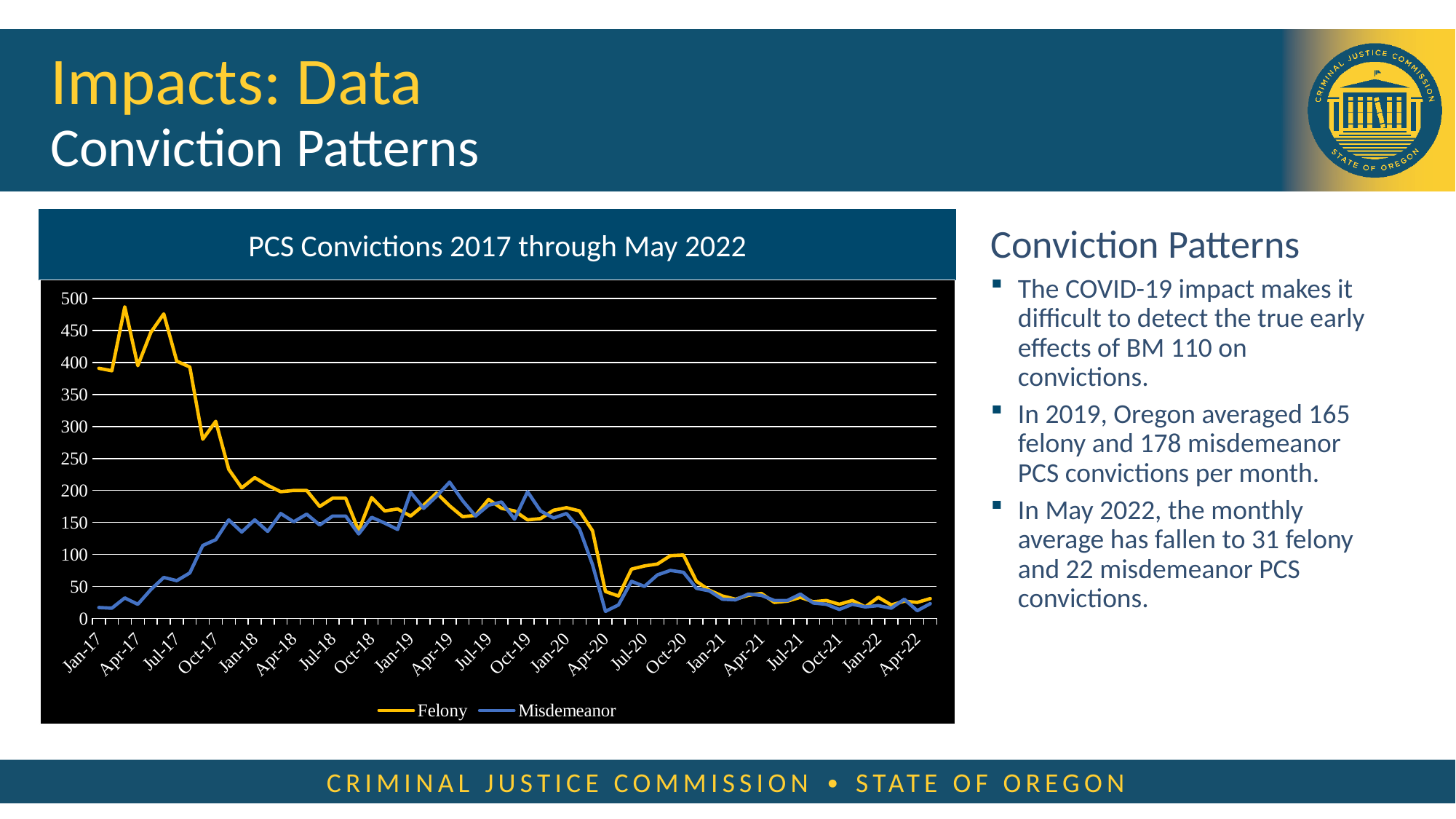
In Oct-19, which series has the larger value, Felony or Misdemeanor? Misdemeanor Which series reaches the highest value anywhere on the chart? Felony Overall, does the Felony line rise or fall from Jan-17 to Apr-22? fall In Jan-17, which series has the larger value, Felony or Misdemeanor? Felony Is the Felony value for Apr-20 greater or less than 100? less What kind of chart is shown on the slide? line chart Is the Misdemeanor value for Apr-19 greater or less than 150? greater What is the title of the chart? PCS Convictions 2017 through May 2022 How many series does the legend of the chart list? 2 Is the Felony value for Jan-17 greater or less than 350? greater Which colour is used for the Misdemeanor line in the chart? blue